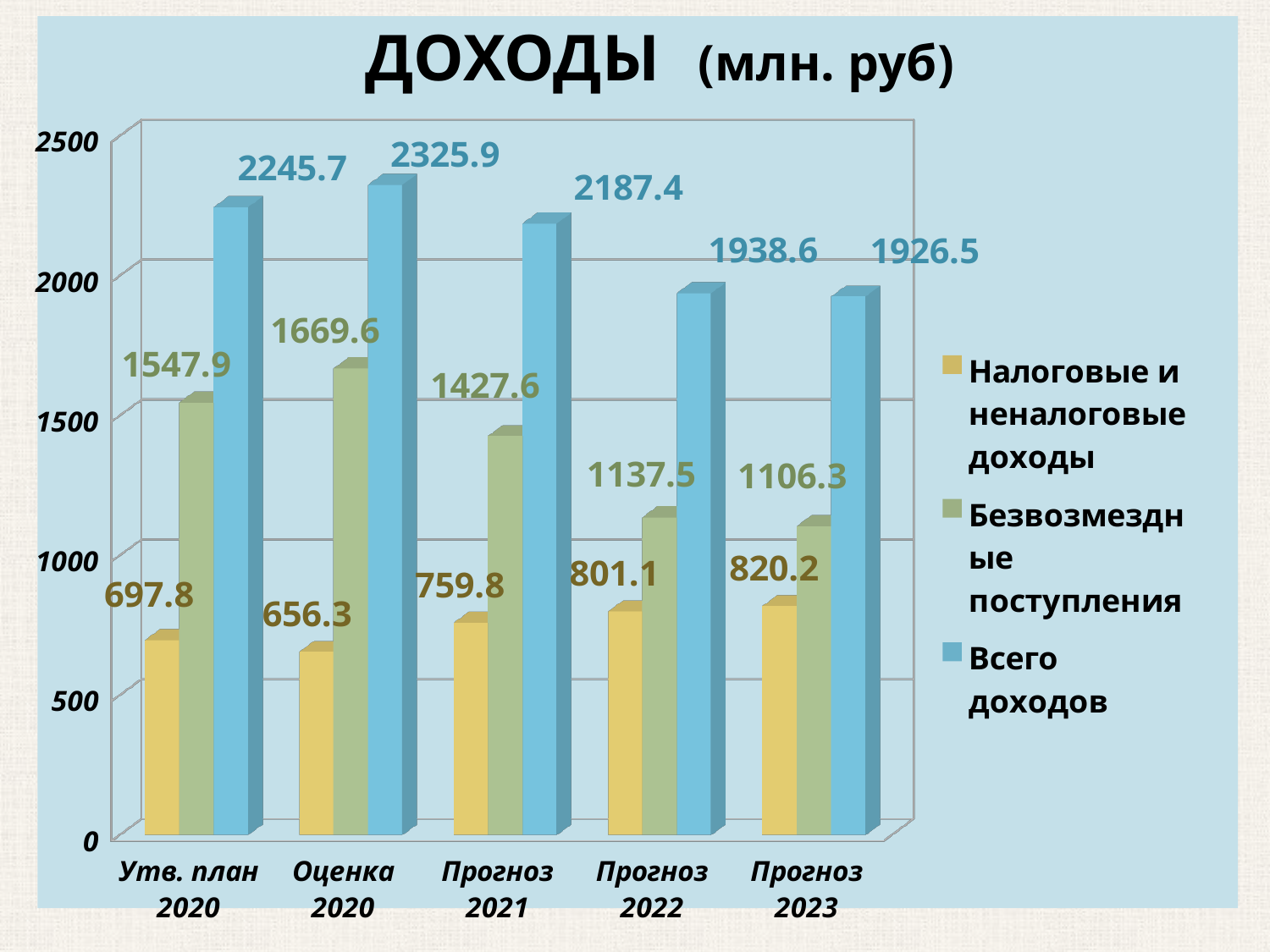
What is the value of Всего доходов for Оценка 2020? 2325.9 What kind of chart is shown on the slide? Bar chart What is the value of Безвозмездные поступления for Прогноз 2021? 1427.6 Do the values for Безвозмездные поступления rise or fall from Оценка 2020 to Прогноз 2023? Fall What is the difference between Всего доходов for Утв. план 2020 and Прогноз 2022? 307.1 How many categories are shown on the x axis? 5 Which category has the lowest value for Налоговые и неналоговые доходы? Оценка 2020 What unit is given in the chart title? млн. руб How many series does the legend list? 3 Which is larger: Безвозмездные поступления for Утв. план 2020 or for Оценка 2020? Оценка 2020 Which category has the highest value for Всего доходов? Оценка 2020 What is the value of Налоговые и неналоговые доходы for Прогноз 2023? 820.2